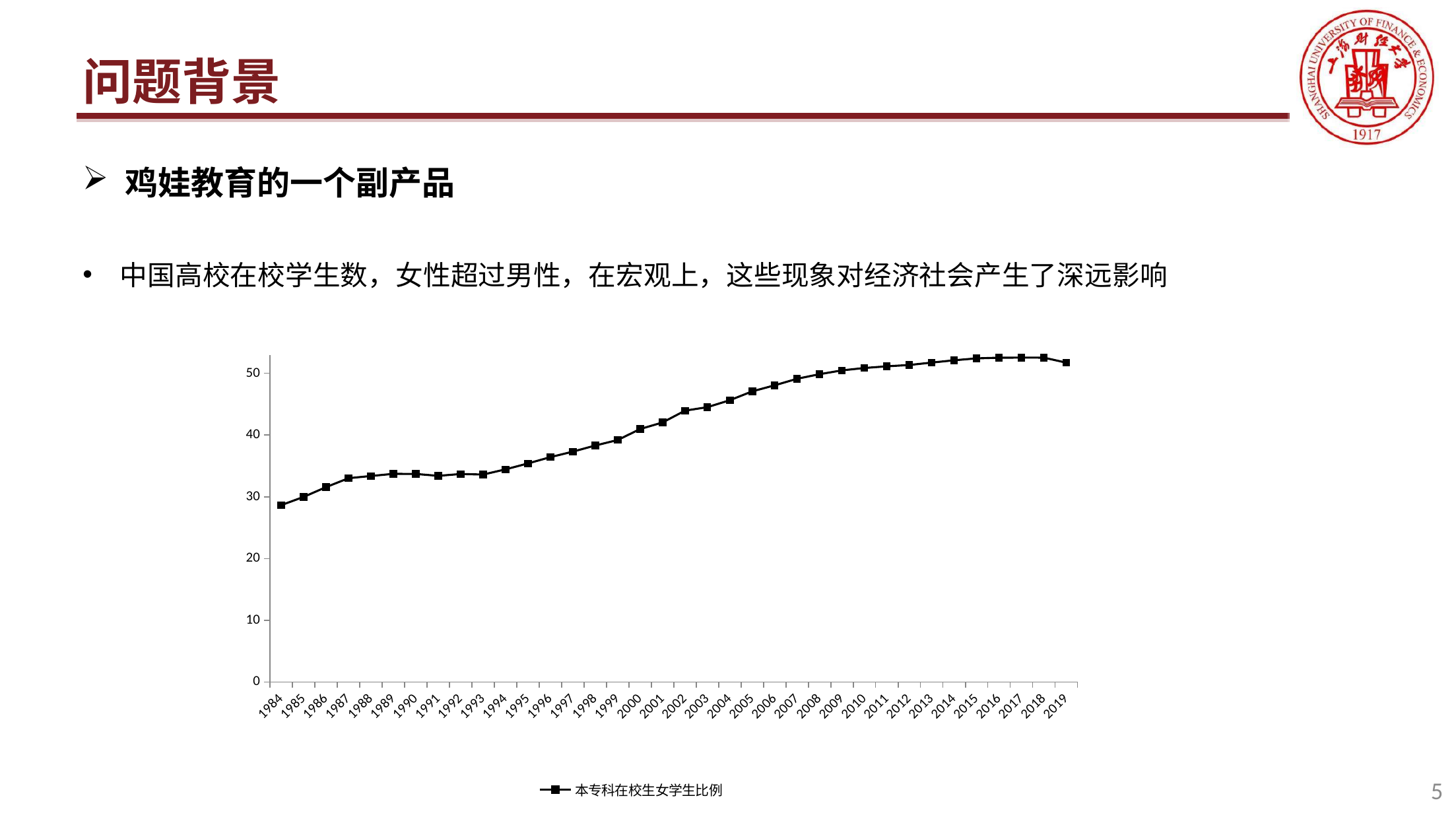
Is the value for 1984 greater or less than 30? less Is the value for 1990 greater or less than 40? less How many series does the legend list? 1 Which year has the lowest value? 1984 How many years (data points) are plotted on the x axis? 36 Is the value for 2019 greater or less than 50? greater Which year has the larger value, 1990 or 2010? 2010 What is the first year shown on the x axis? 1984 What is the name of the series shown in the legend? 本专科在校生女学生比例 What kind of chart is shown on the slide? line chart Do the values generally rise or fall from 1984 to 2019? rise